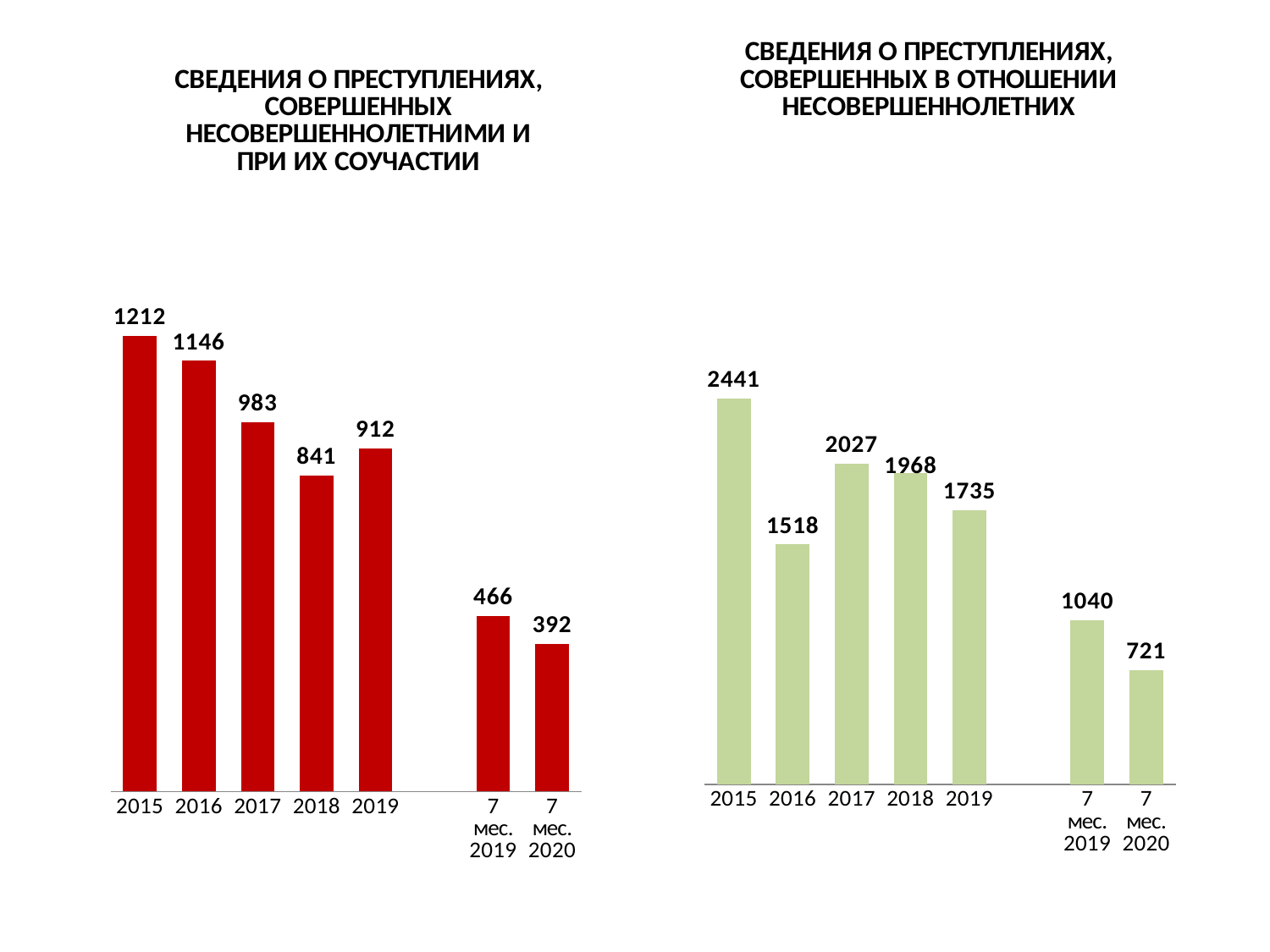
In the right chart (crimes committed against minors), which category has the lowest value? 7 мес. 2020 In the left chart (crimes committed by minors), what is the value for 2015? 1212 In the left chart (crimes committed by minors), what is the difference between the values for 2015 and 2016? 66 In the left chart (crimes committed by minors), which category has the highest value? 2015 How many bars are shown in the right chart (crimes committed against minors)? 7 In the left chart (crimes committed by minors), which is larger, the value for 2018 or the value for 2019? 2019 In the right chart (crimes committed against minors), which is larger, the value for 2016 or the value for 2019? 2019 In the right chart (crimes committed against minors), what is the value for 2017? 2027 In the right chart (crimes committed against minors), what is the difference between the values for 7 мес. 2019 and 7 мес. 2020? 319 What type of chart is the left chart (crimes committed by minors)? Bar chart In the right chart (crimes committed against minors), what is the value for 7 мес. 2019? 1040 In the left chart (crimes committed by minors), what is the value for 7 мес. 2020? 392